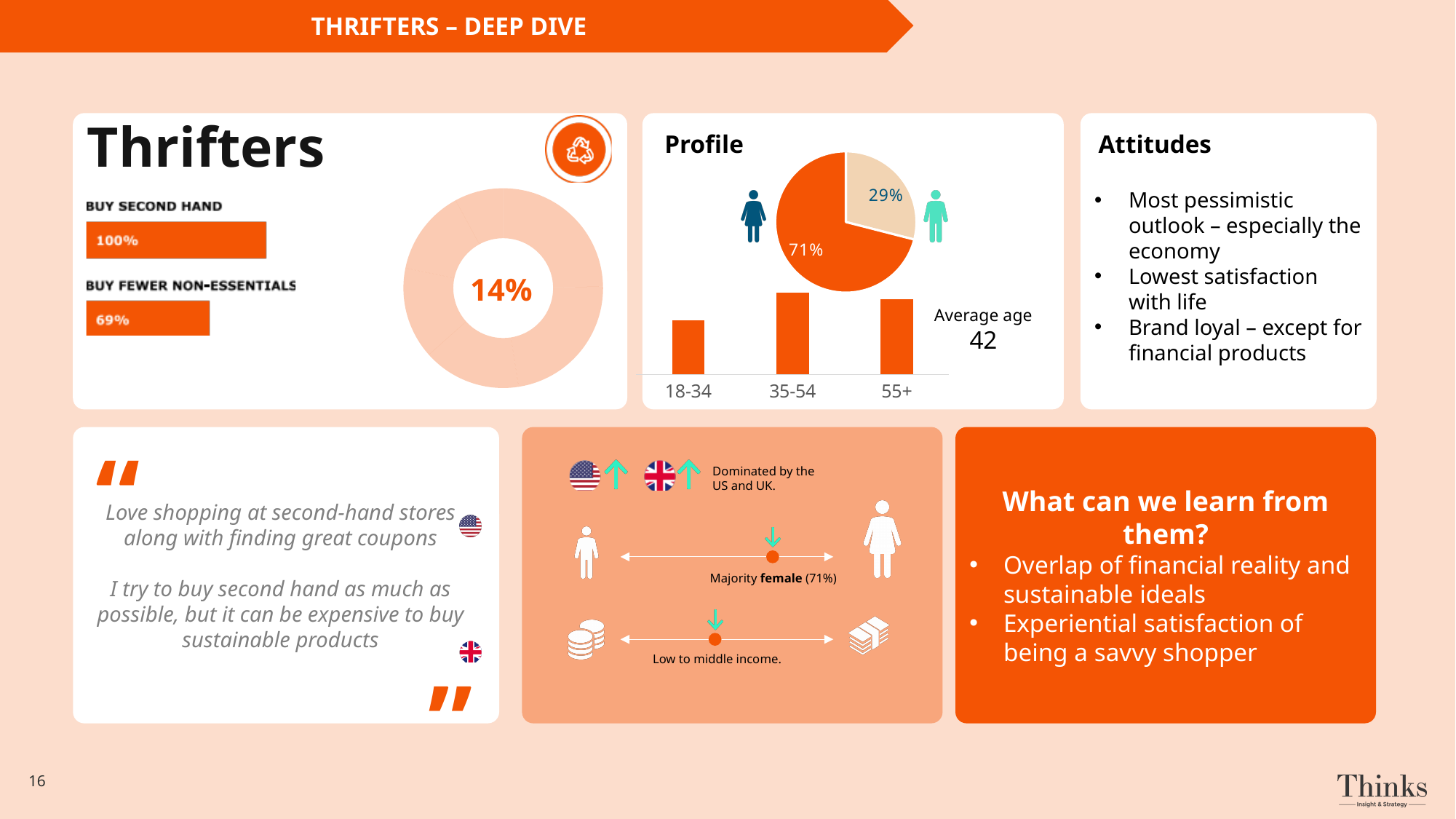
In the pie chart in the Profile section, what percentage is shown for the smaller beige slice? 29% In the horizontal bar chart in the Thrifters panel, what is the value for 'Buy fewer non-essentials'? 69% How many slices does the pie chart in the Profile section have? 2 In the pie chart in the Profile section, what is the difference between the two slices' percentages? 42 percentage points In the age bar chart in the Profile section, which bar is taller: 18-34 or 55+? 55+ In the age bar chart in the Profile section, which age group has the shortest bar? 18-34 In the pie chart in the Profile section, what percentage is shown for the larger orange slice? 71% In the horizontal bar chart in the Thrifters panel, what is the value for 'Buy second hand'? 100% What percentage is shown in the centre of the donut chart in the Thrifters panel? 14% In the age bar chart in the Profile section, which age group has the tallest bar? 35-54 How many age groups are shown in the age bar chart in the Profile section? 3 What kind of chart is used to show the age groups in the Profile section? Bar chart